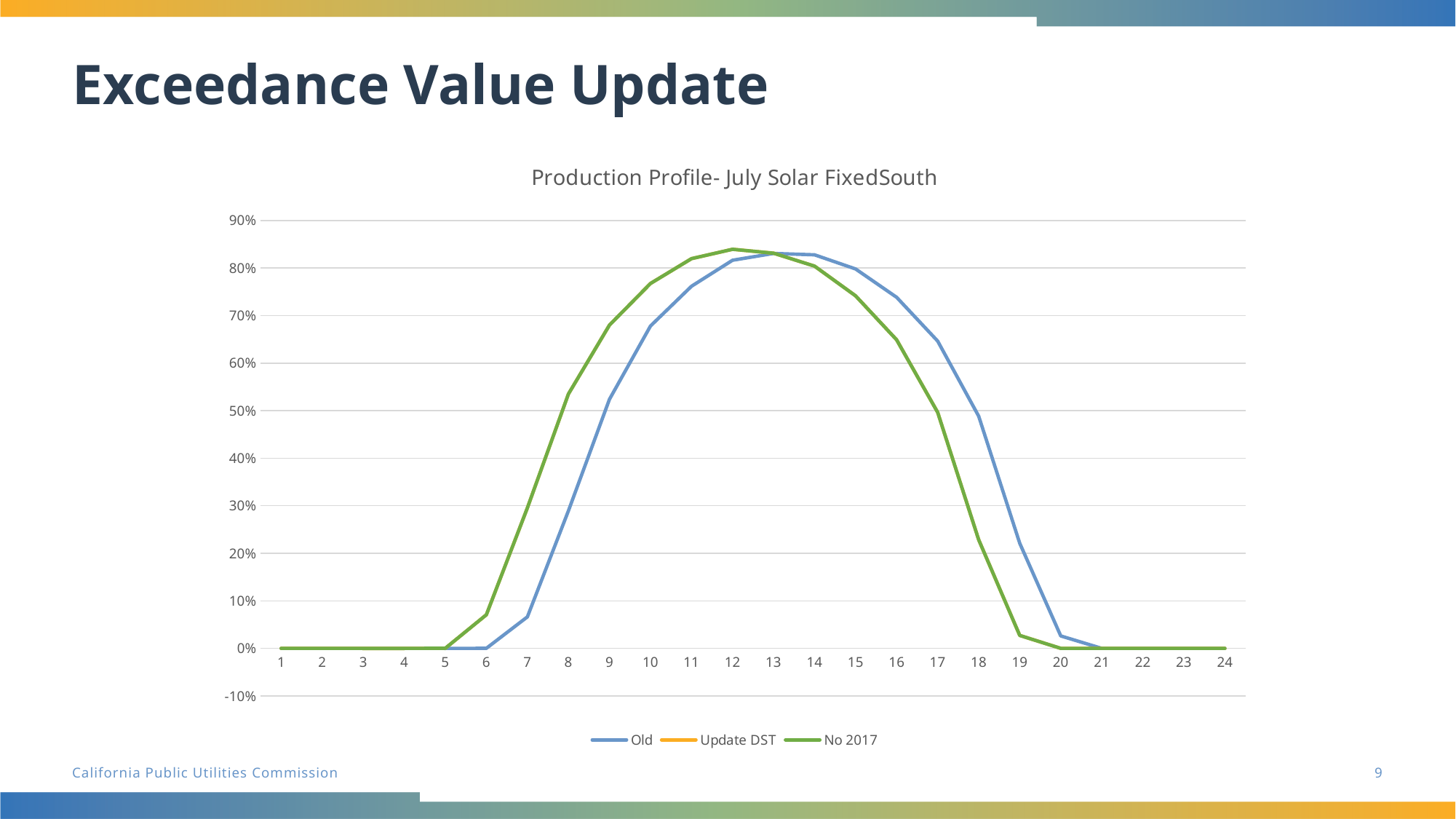
Is the value for the Old series at hour 7 greater or less than 10%? less What is the title of the chart? Production Profile- July Solar FixedSouth How many points are plotted along the x axis for each series? 24 Is the value for the No 2017 series at hour 8 greater or less than 50%? greater At hour 17, which series has the larger value, Old or No 2017? Old What kind of chart is shown on the slide? line chart Does the Old series rise or fall between hour 6 and hour 13? rise At hour 8, which series has the larger value, Old or No 2017? No 2017 Which series is drawn in green in the legend? No 2017 How many series does the legend list? 3 Is the value for the Old series at hour 10 greater or less than 70%? less What is the value for the Old series at hour 3? 0%